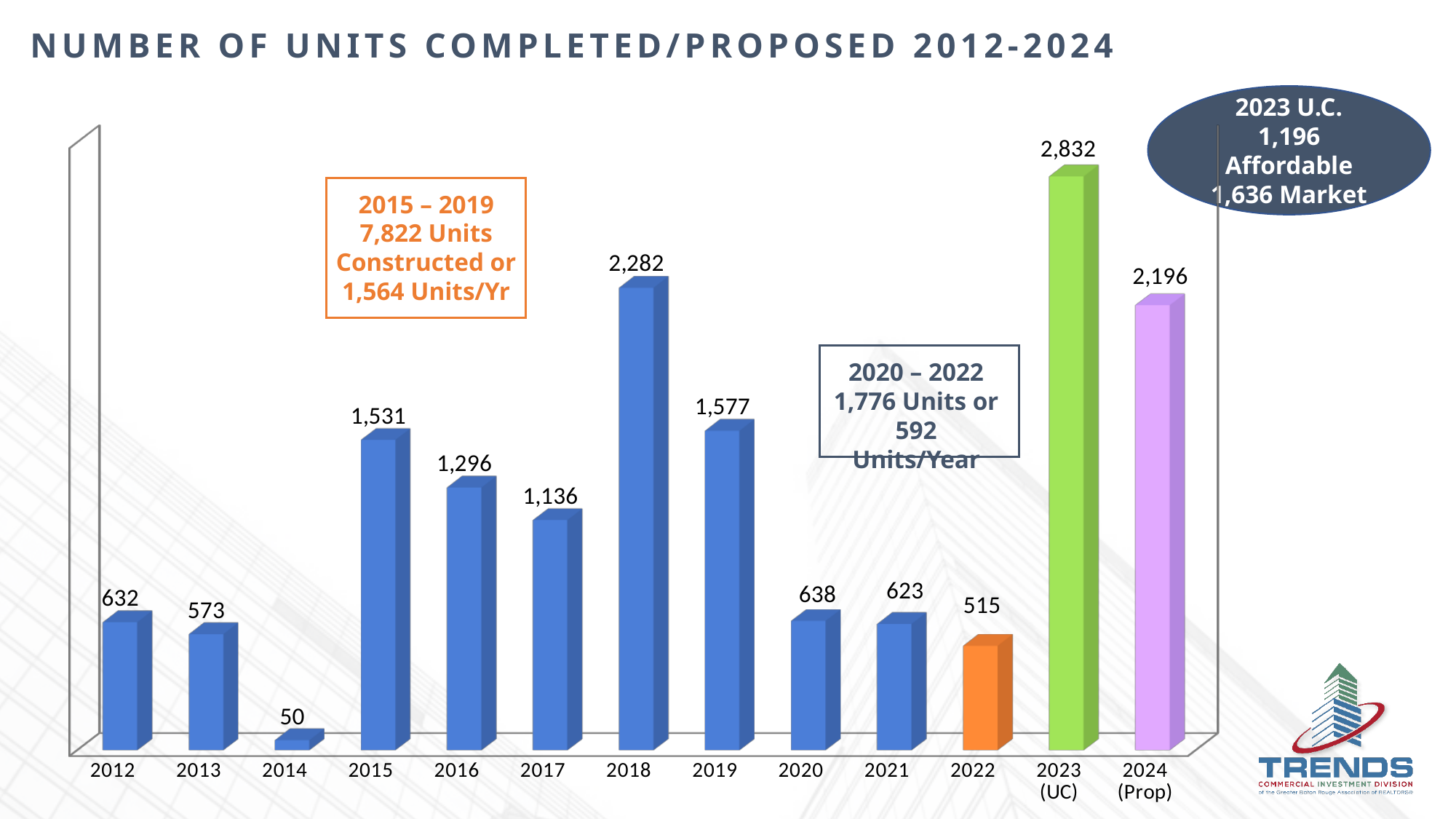
Which year has the highest number of units? 2023 (UC) Which year has the lowest number of units? 2014 What is the number of units for 2018? 2,282 What is the number of units for 2014? 50 What is the difference between the 2018 value and the 2019 value? 705 What kind of chart is shown on the slide? Bar chart Which is larger, the value for 2016 or the value for 2017? 2016 What is the number of units shown for 2024 (Prop)? 2,196 Do the values rise or fall from 2019 to 2022? Fall What is the difference between the 2023 (UC) value and the 2024 (Prop) value? 636 How many years (bars) are shown on the chart? 13 What is the number of units shown for 2023 (UC)? 2,832